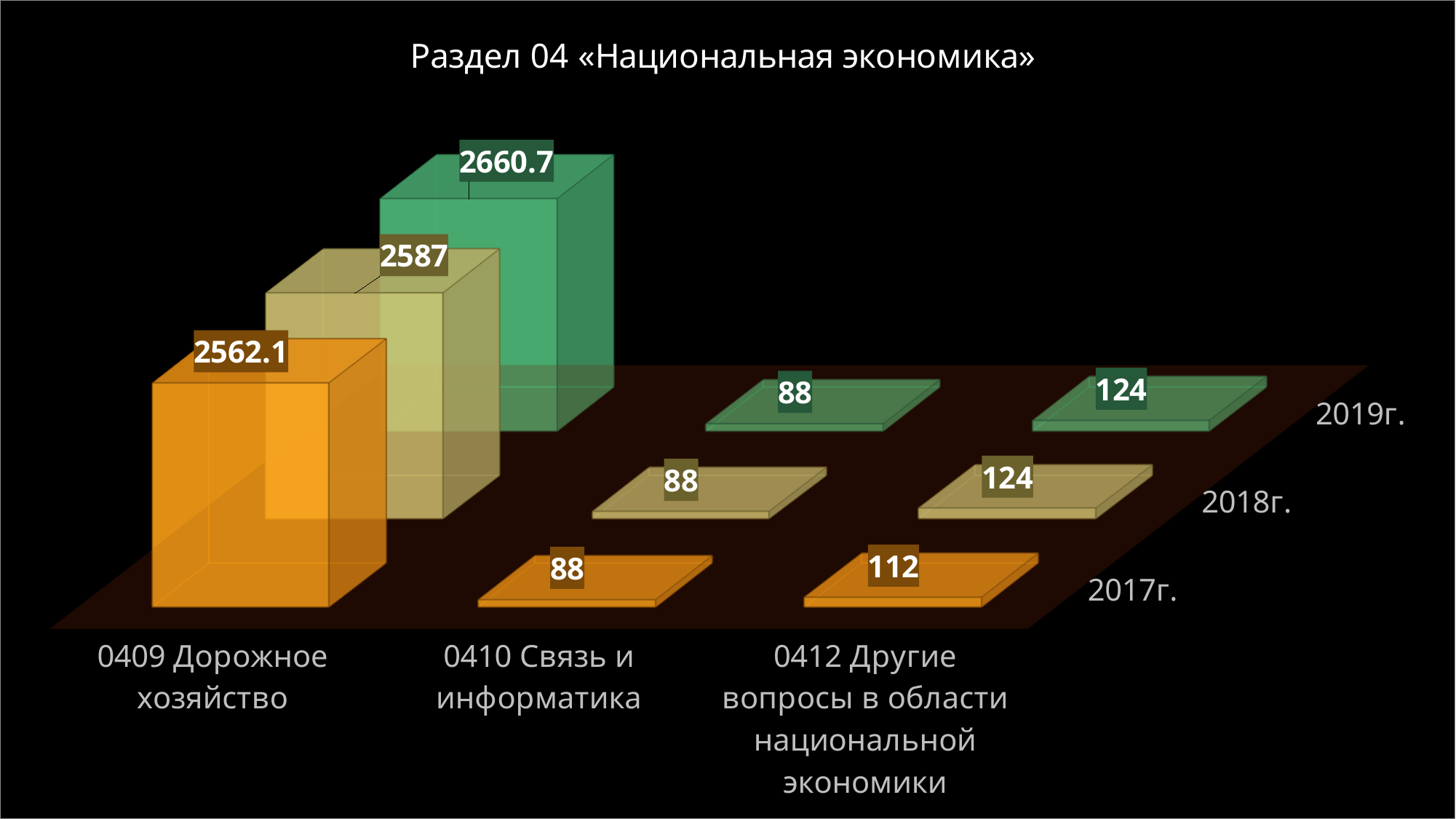
Which is larger: the 2018г. value for 0412 Другие вопросы в области национальной экономики or the 2018г. value for 0410 Связь и информатика? 0412 Другие вопросы в области национальной экономики What is the value for 0412 Другие вопросы в области национальной экономики in 2017г.? 112 Which category has the highest value in 2019г.? 0409 Дорожное хозяйство What kind of chart is shown on the slide? bar chart What is the value for 0409 Дорожное хозяйство in 2017г.? 2562.1 What is the difference between the 2018г. and 2017г. values for 0412 Другие вопросы в области национальной экономики? 12 How many categories are shown on the x axis? 3 How many years (series) are plotted in the chart? 3 What is the difference between the 2019г. and 2017г. values for 0409 Дорожное хозяйство? 98.6 What is the value for 0410 Связь и информатика in 2018г.? 88 Which category has the lowest value in 2017г.? 0410 Связь и информатика What is the value for 0409 Дорожное хозяйство in 2019г.? 2660.7